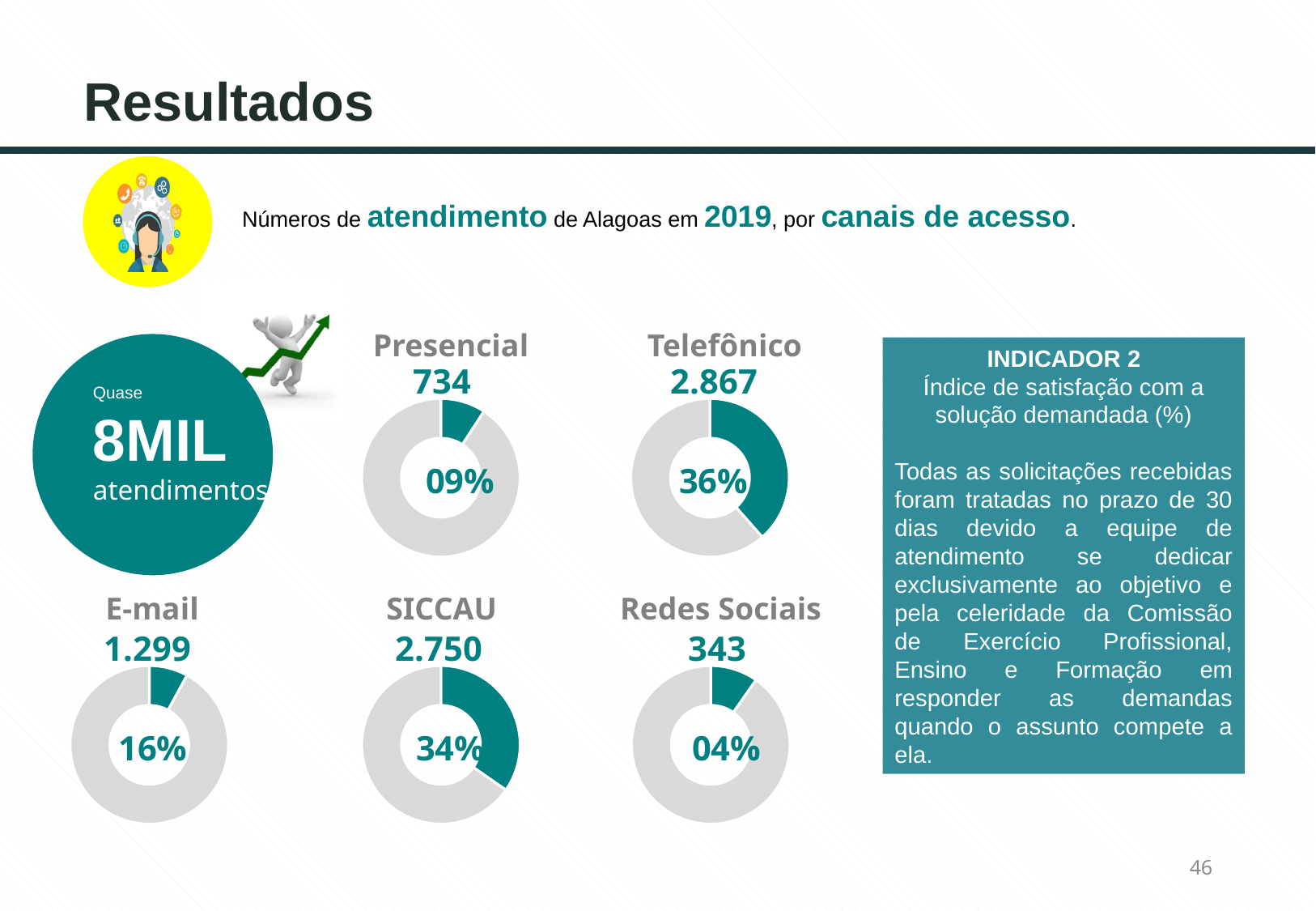
What is the difference between the percentage on the SICCAU donut chart and the percentage on the E-mail donut chart? 18% On the Presencial donut chart, what percentage is shown in the centre? 09% What is the difference between the number printed above the Telefônico donut chart and the number printed above the SICCAU donut chart? 117 How many donut charts are shown on the slide? 5 On the SICCAU donut chart, what number of atendimentos is printed above the chart? 2.750 Across the five donut charts, which channel has the lowest percentage? Redes Sociais Across the five donut charts, which channel has the highest percentage? Telefônico On the Telefônico donut chart, what number of atendimentos is printed above the chart? 2.867 On the Redes Sociais donut chart, what percentage is shown in the centre? 04% On the E-mail donut chart, what percentage is shown in the centre? 16% What kind of chart is used to show the share for each channel on the slide? Donut chart Which is larger, the percentage on the E-mail donut chart or the percentage on the Presencial donut chart? E-mail